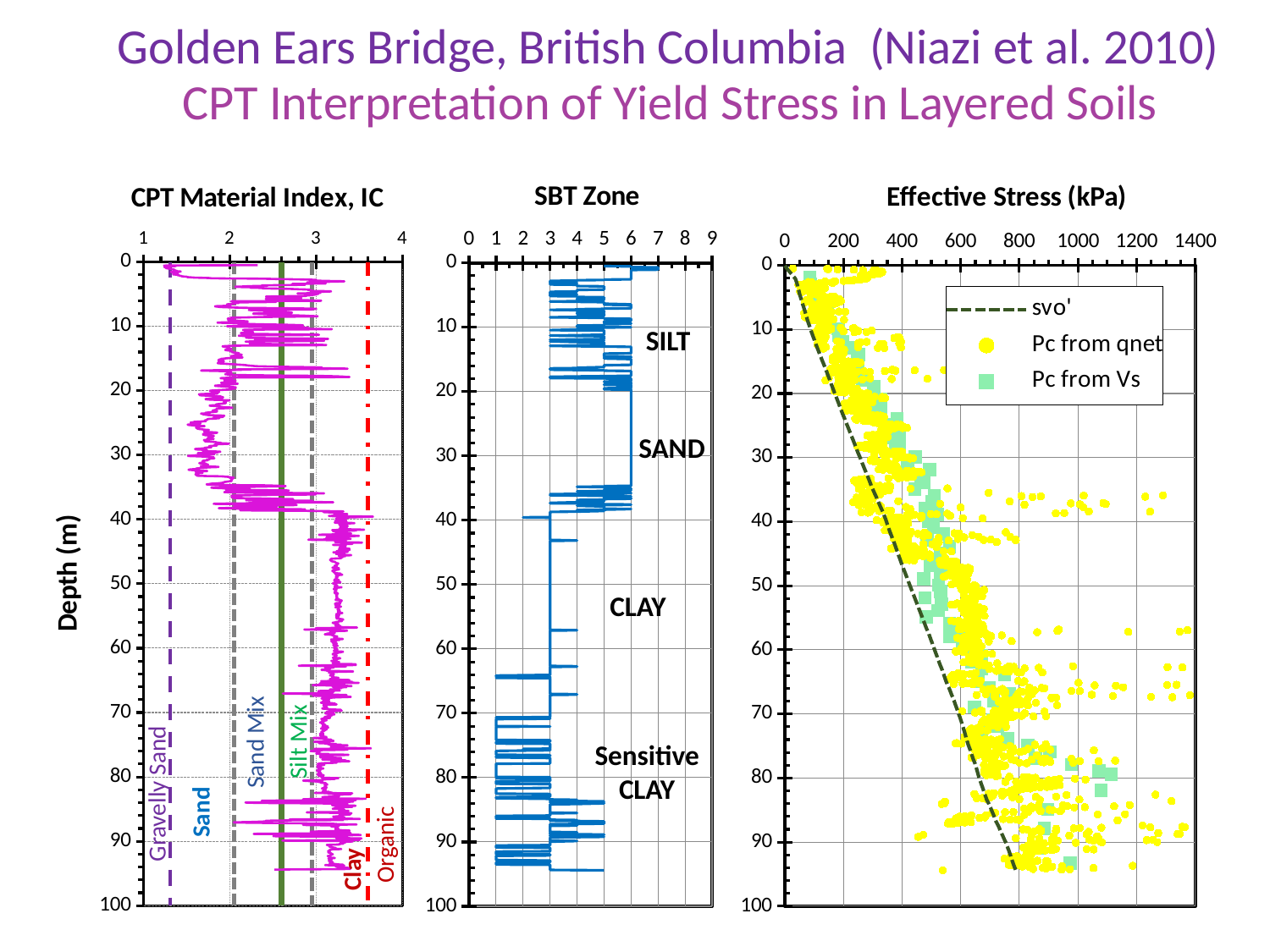
In the SBT Zone chart, which soil label is shown between SILT and CLAY? SAND What are the three legend entries in the Effective Stress (kPa) chart? svo', Pc from qnet, Pc from Vs What is the maximum value shown on the x axis of the Effective Stress (kPa) chart? 1400 In the SBT Zone chart, is the SBT zone value at a depth of 50 m greater or less than 5? less How many series does the legend of the Effective Stress (kPa) chart list? 3 In the Effective Stress (kPa) chart, does the svo' line increase or decrease as depth increases? increase In the Effective Stress (kPa) chart, is the svo' value at a depth of 90 m greater or less than 600? greater In the CPT Material Index, IC chart, is the IC value at a depth of 50 m greater or less than 3? greater How many vertical reference lines are drawn on the CPT Material Index, IC chart? 5 What kind of chart is the Effective Stress (kPa) chart? scatter plot